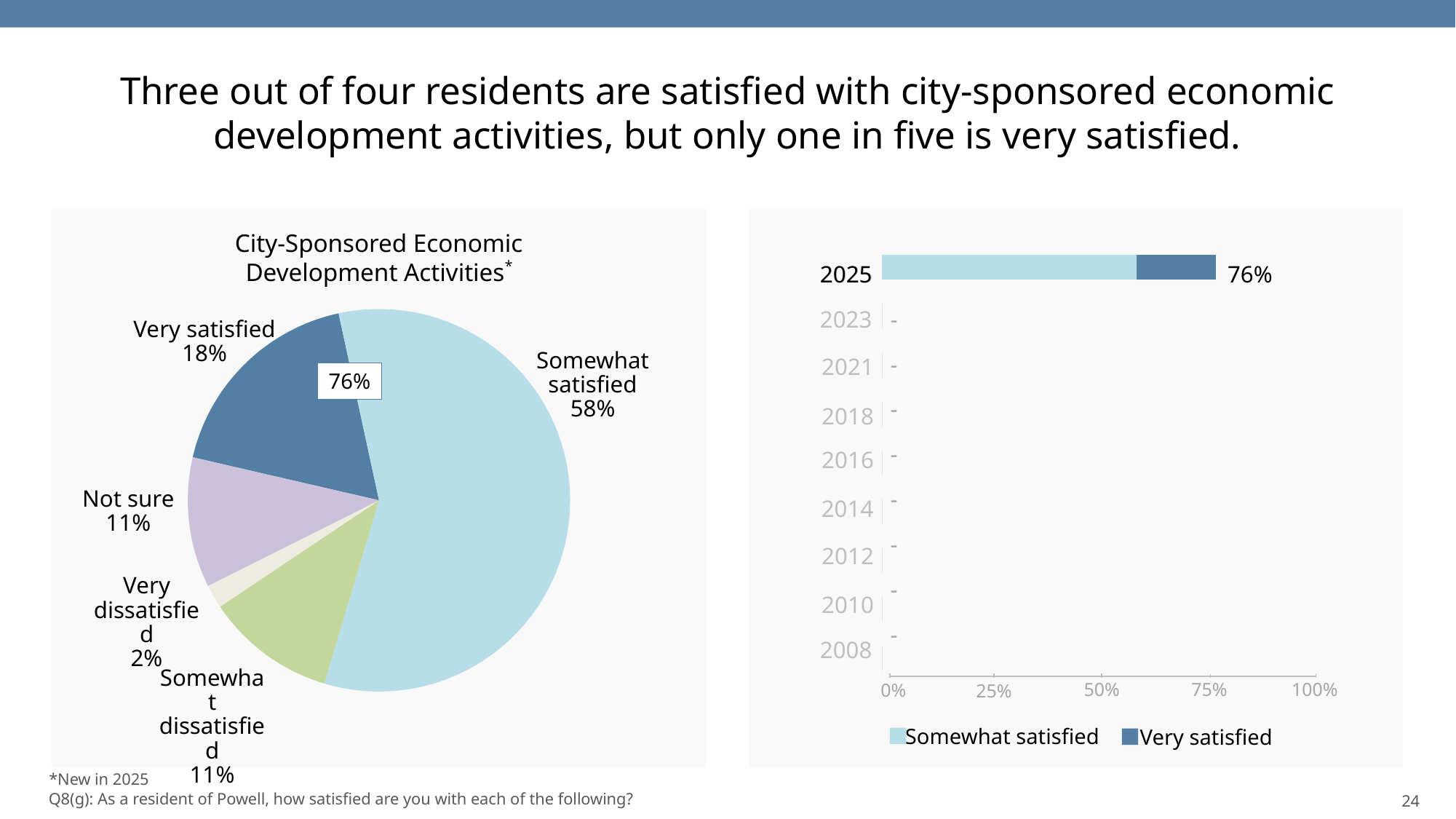
In the pie chart on the left, how many slices are there? 5 In the pie chart on the left, what share of residents are very satisfied? 18% In the bar chart on the right, what is the total satisfied value shown for 2025? 76% In the bar chart on the right, how many series does the legend list? 2 In the pie chart on the left, which category has the smallest slice? Very dissatisfied In the pie chart on the left, what share of residents are somewhat satisfied? 58% What type of chart is shown on the right side of the slide? Bar chart In the pie chart on the left, which category has the largest slice? Somewhat satisfied In the bar chart on the right, how many years are listed on the vertical axis? 9 In the pie chart on the left, what share of residents are very dissatisfied? 2% In the pie chart on the left, what share of residents are not sure? 11% In the pie chart on the left, what is the difference between the somewhat satisfied and very satisfied shares? 40%